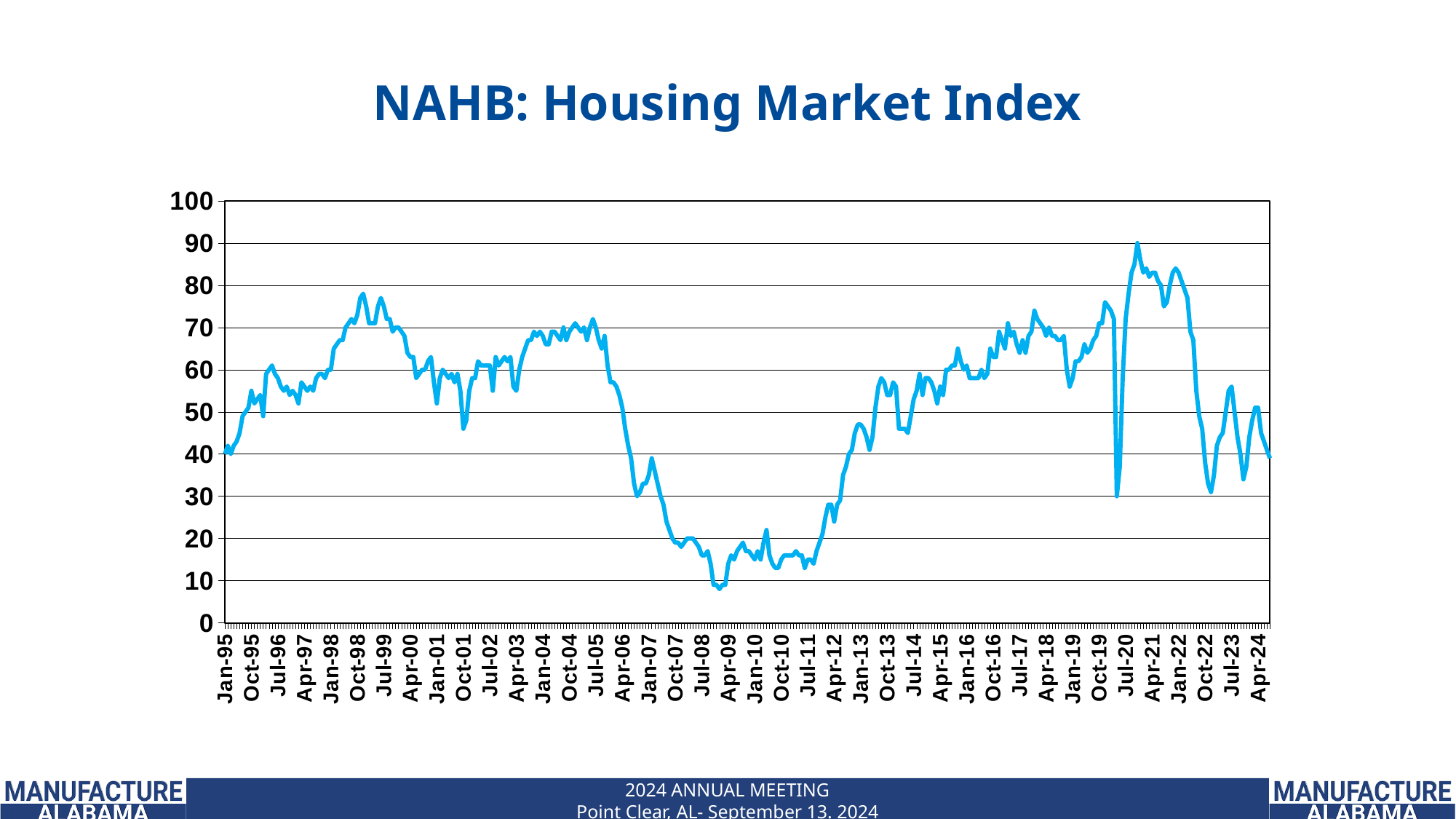
Is the value around Jan-13 greater or less than 40? greater Does the index rise or fall between Jan-09 and Jan-13? rise What kind of chart is shown on the slide? line chart What is the title of the chart? NAHB: Housing Market Index Is the value around Oct-98 greater or less than 70? greater Is the value around Jan-07 greater or less than 50? less What is the highest value shown on the vertical axis? 100 In which period does the index reach its lowest point: around Jan-09 or around Jan-07? around Jan-09 Does the index rise or fall between Apr-05 and Jan-09? fall